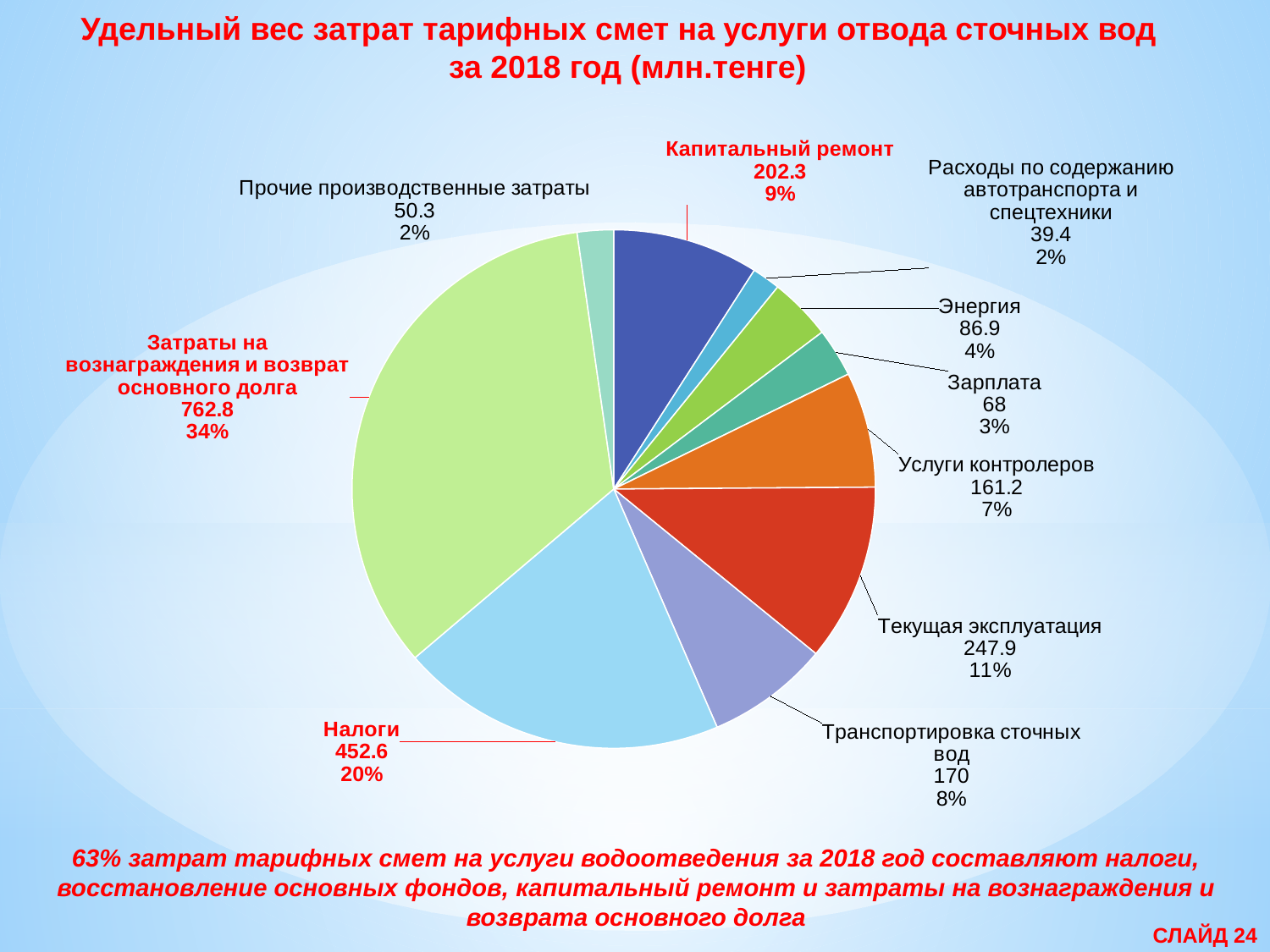
What year does the chart title refer to? 2018 What is the difference between the values for Налоги and Капитальный ремонт? 250.3 What is the value shown for Налоги? 452.6 What share of the pie does Затраты на вознаграждения и возврат основного долга represent? 34% Which category has the smallest value in the pie chart? Расходы по содержанию автотранспорта и спецтехники What kind of chart is shown on the slide? pie chart Which is larger, the value for Услуги контролеров or the value for Транспортировка сточных вод? Транспортировка сточных вод What is the value shown for Текущая эксплуатация? 247.9 How many slices does the pie chart have? 10 What percentage is shown for Капитальный ремонт? 9% Which category has the largest slice of the pie? Затраты на вознаграждения и возврат основного долга What is the value shown for Энергия? 86.9